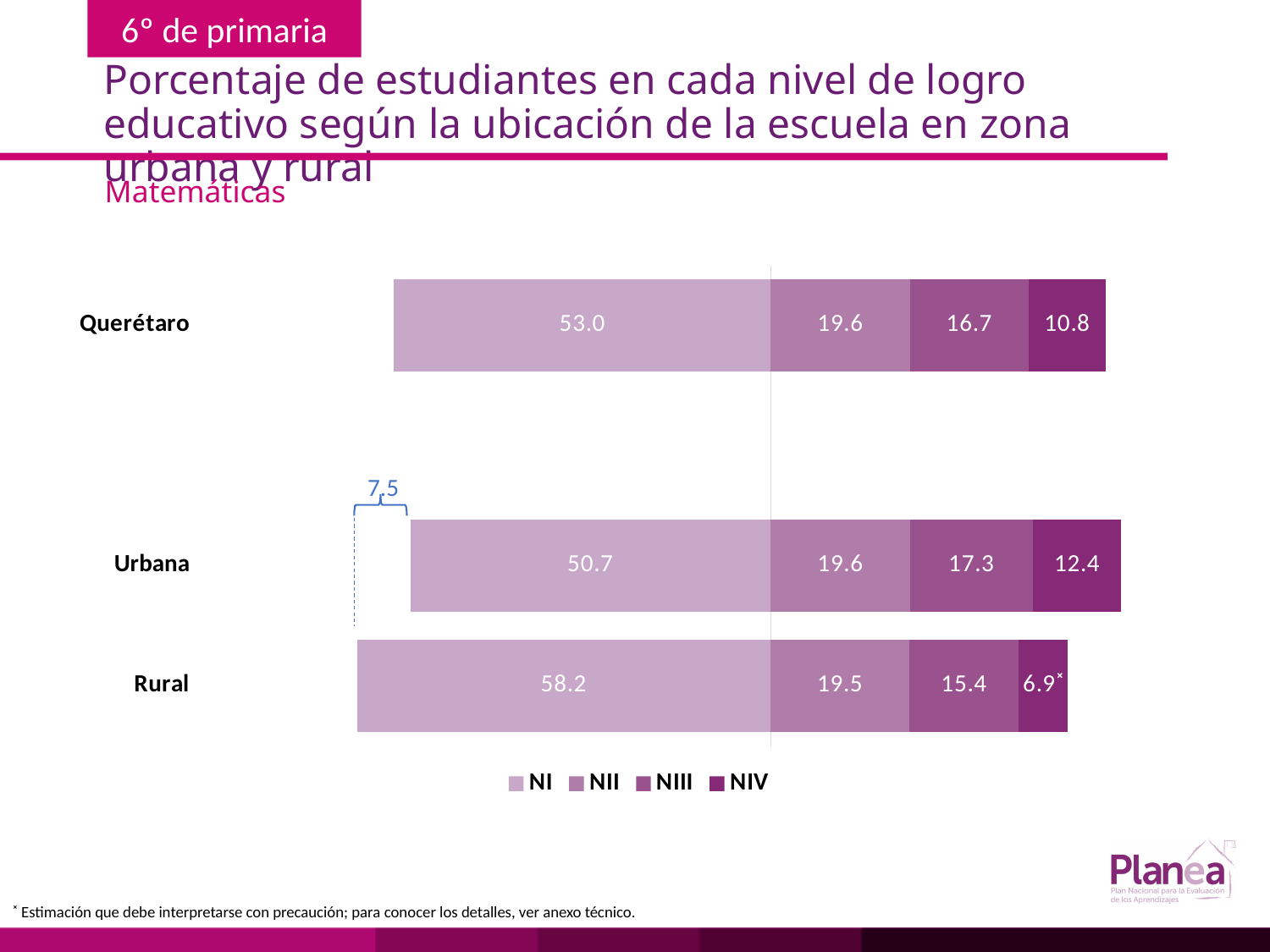
Which category has the highest NI value? Rural Which is larger, the NIII value for Urbana or the NIII value for Rural? Urbana What is the NII value for Rural? 19.5 What type of chart is shown on the slide? Stacked bar chart How many categories are plotted in the chart? 3 What is the NIII value for Querétaro? 16.7 How many series does the legend list? 4 Which legend entry is shown in the darkest colour? NIV What is the NIV value for Urbana? 12.4 What is the NI value for Rural? 58.2 What is the difference between the NI values for Rural and Urbana? 7.5 Which category has the lowest NIV value? Rural